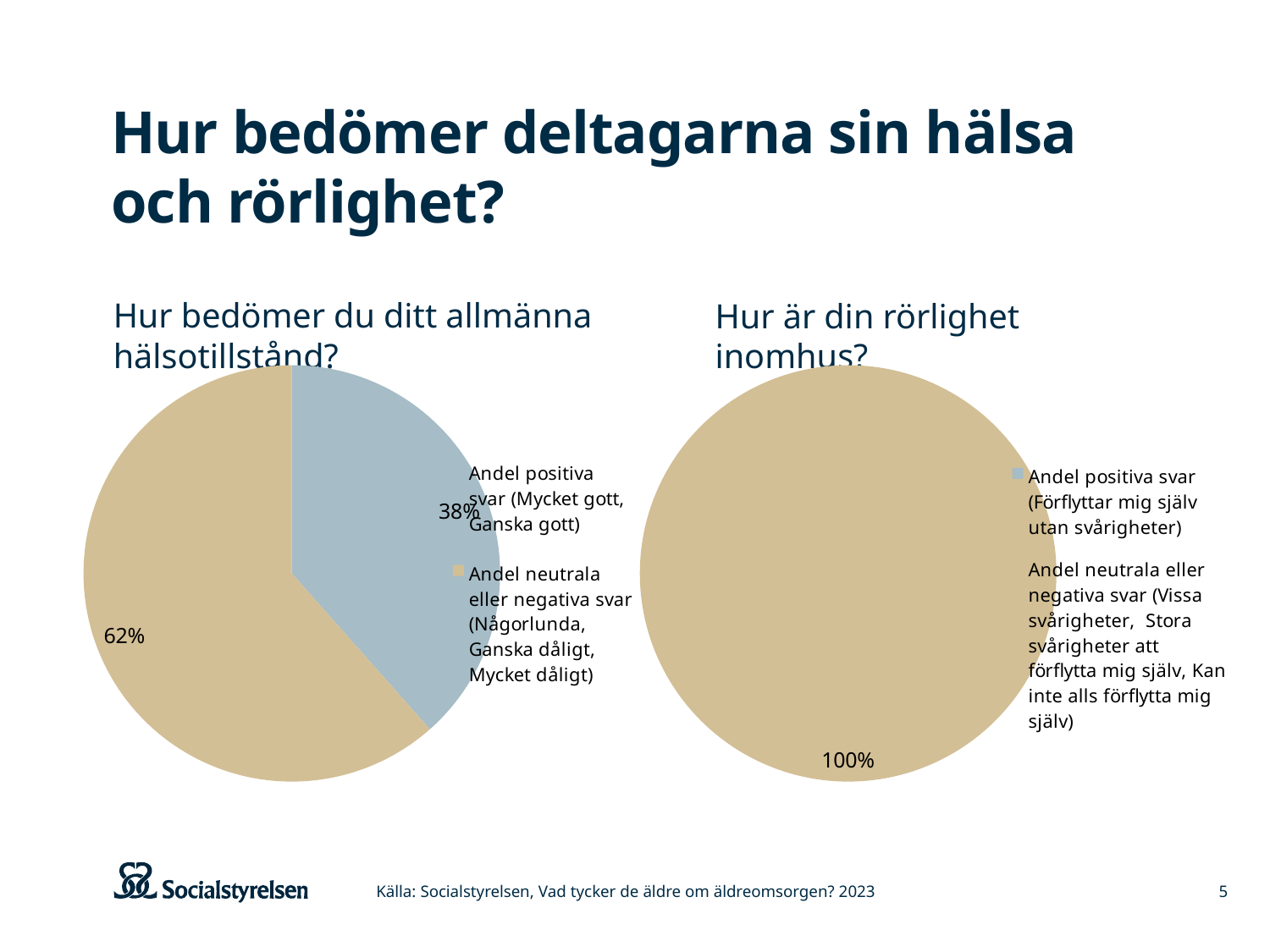
How many entries does the legend of the right chart (Hur är din rörlighet inomhus?) list? 2 How many charts are shown on the slide? 2 In the left chart (Hur bedömer du ditt allmänna hälsotillstånd?), which category has the largest slice? Andel neutrala eller negativa svar What type of chart is used on the left side of the slide? Pie chart In the left chart (Hur bedömer du ditt allmänna hälsotillstånd?), which category has the smallest slice? Andel positiva svar In the left chart (Hur bedömer du ditt allmänna hälsotillstånd?), what share is labelled for 'Andel positiva svar'? 38% In the left chart (Hur bedömer du ditt allmänna hälsotillstånd?), what share is labelled for 'Andel neutrala eller negativa svar'? 62% What is the title of the chart on the right side of the slide? Hur är din rörlighet inomhus? In the left chart (Hur bedömer du ditt allmänna hälsotillstånd?), is the share of positive answers larger or smaller than the share of neutral or negative answers? smaller What type of chart is used on the right side of the slide? Pie chart In the left chart (Hur bedömer du ditt allmänna hälsotillstånd?), what is the difference in percentage points between the neutral/negative share and the positive share? 24 percentage points In the right chart (Hur är din rörlighet inomhus?), what percentage is printed on the pie? 100%